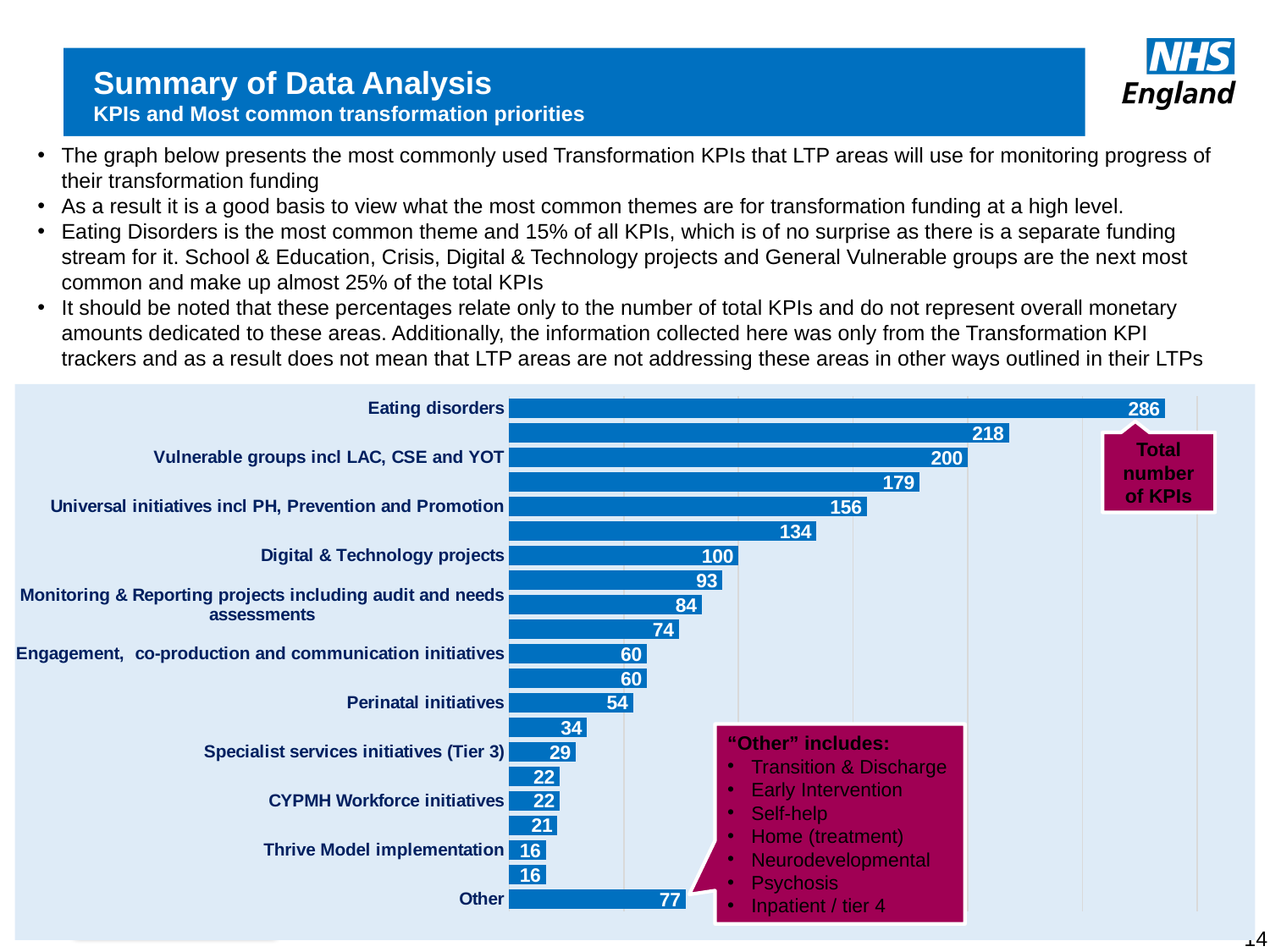
What is the difference between the values for Digital & Technology projects and Perinatal initiatives? 46 What is the value for Vulnerable groups incl LAC, CSE and YOT? 200 What is the value for Other? 77 Which is larger, the value for Other or the value for Monitoring & Reporting projects including audit and needs assessments? Monitoring & Reporting projects including audit and needs assessments Which category has the highest value? Eating disorders What type of chart is shown on the slide? bar chart According to the text box on the chart, what do the bar values represent? Total number of KPIs What is the difference between the values for Eating disorders and Vulnerable groups incl LAC, CSE and YOT? 86 What is the value for Digital & Technology projects? 100 What is the value for Eating disorders? 286 How many bars are plotted in the chart? 21 What is the value for Thrive Model implementation? 16